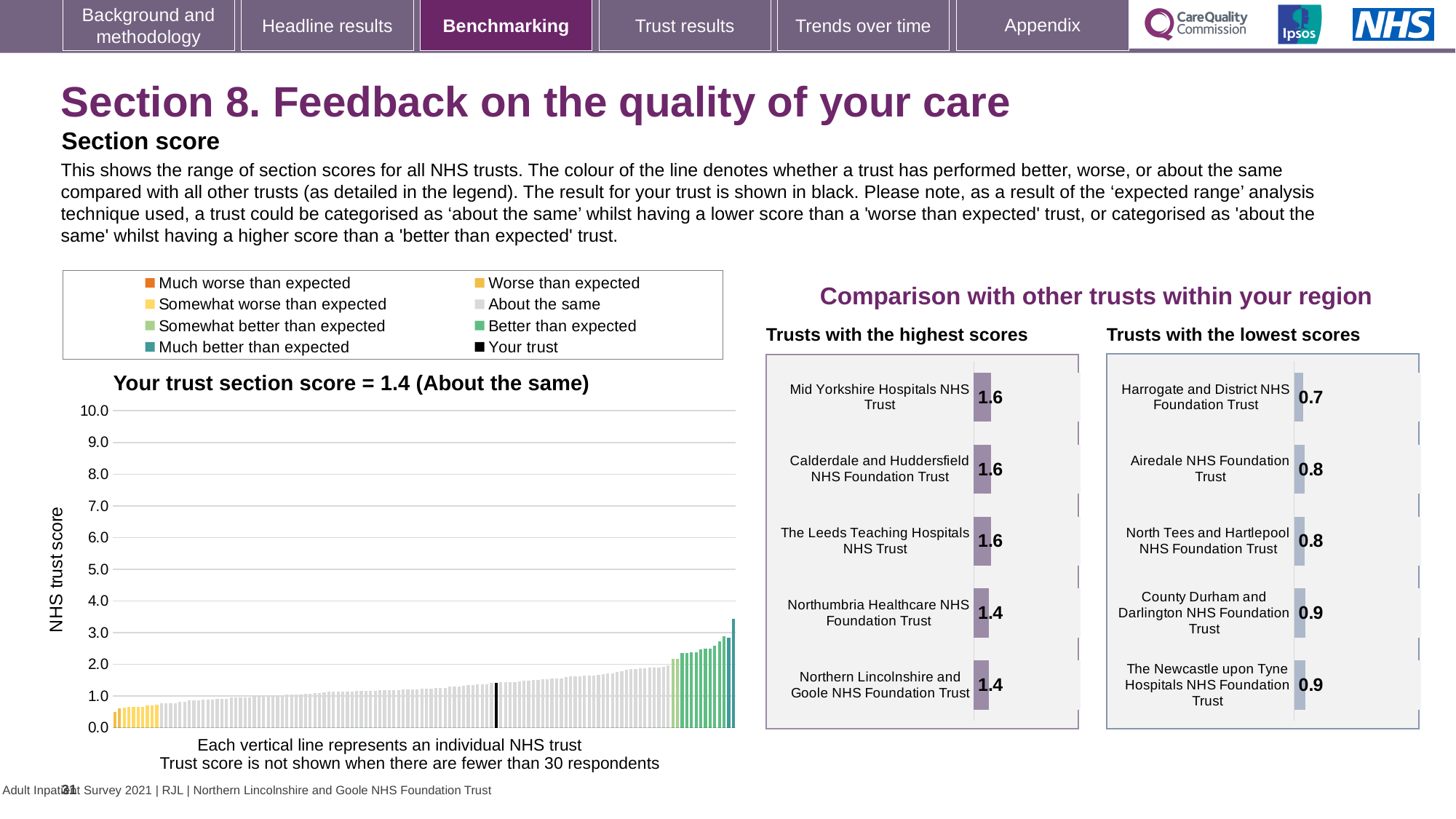
On the 'Trusts with the lowest scores' chart, which has the larger score: Airedale NHS Foundation Trust or County Durham and Darlington NHS Foundation Trust? County Durham and Darlington NHS Foundation Trust On the 'Your trust section score' chart, is the value of the tallest bar greater or less than 3.0? greater On the 'Your trust section score' chart, what is the section score for your trust? 1.4 On the 'Trusts with the lowest scores' chart, what is the score for Airedale NHS Foundation Trust? 0.8 On the 'Your trust section score' chart, do the bars rise or fall from left to right? rise How many entries does the legend above the 'Your trust section score' chart list? 8 On the 'Trusts with the lowest scores' chart, which trust has the lowest score? Harrogate and District NHS Foundation Trust What kind of chart is the 'Your trust section score' chart? bar chart On the 'Trusts with the highest scores' chart, what is the score for Northumbria Healthcare NHS Foundation Trust? 1.4 On the 'Trusts with the highest scores' chart, how many trusts are listed? 5 On the 'Trusts with the highest scores' chart, what is the difference between the scores of Mid Yorkshire Hospitals NHS Trust and Northern Lincolnshire and Goole NHS Foundation Trust? 0.2 On the 'Your trust section score' chart, what is the highest value shown on the y axis? 10.0